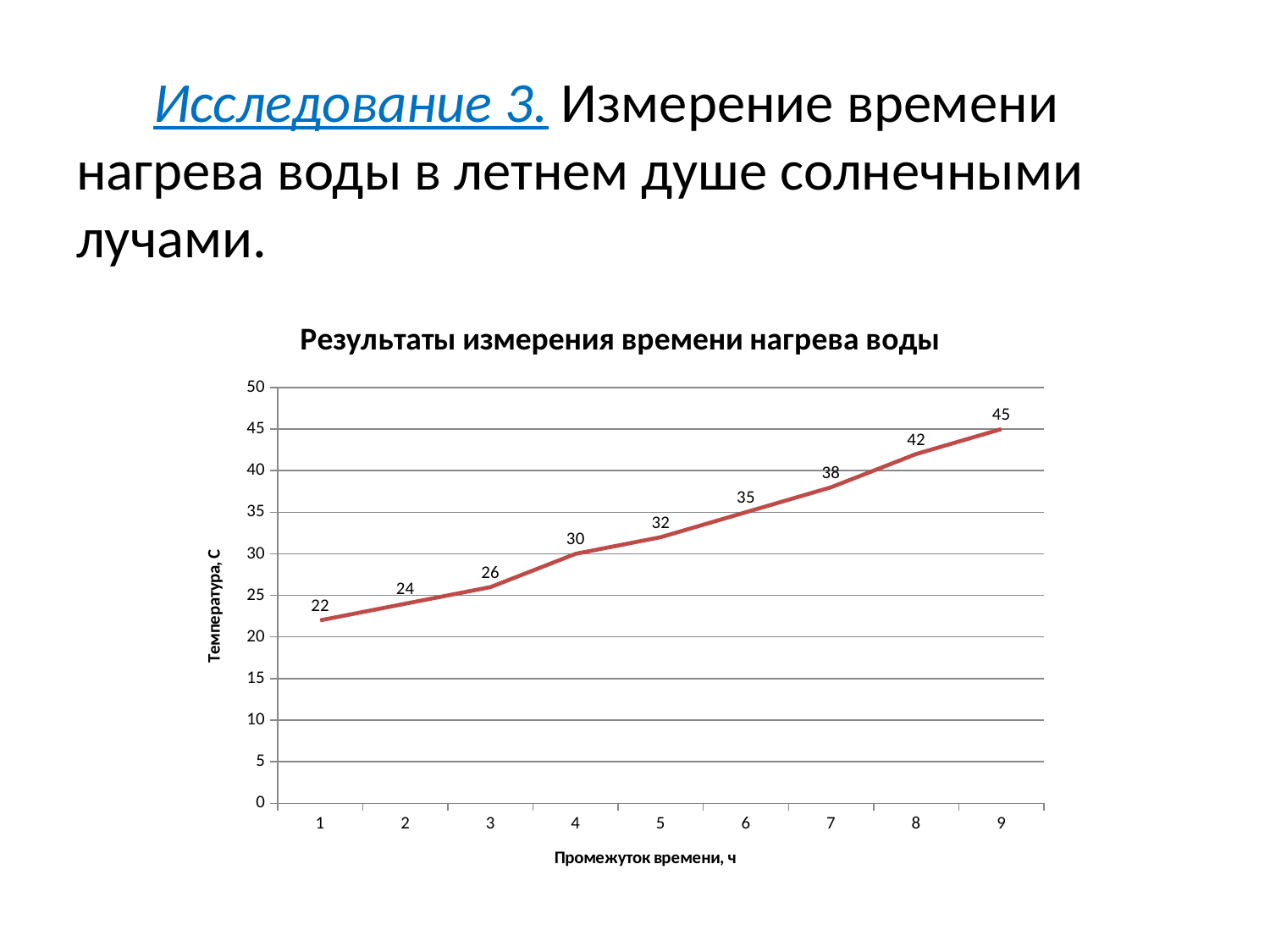
What is the difference between the temperature at interval 9 and at interval 1? 23 What is the difference between the temperature at interval 4 and at interval 3? 4 How many time intervals are plotted on the chart? 9 What is the temperature at time interval 8? 42 What kind of chart is shown on the slide? line chart What is the temperature at time interval 1? 22 What is the temperature at time interval 5? 32 Does the temperature rise or fall as the time interval increases? rise Which is larger, the temperature at interval 6 or at interval 7? interval 7 At which time interval is the temperature highest? 9 At which time interval is the temperature lowest? 1 Is the temperature at interval 7 greater or less than 40? less